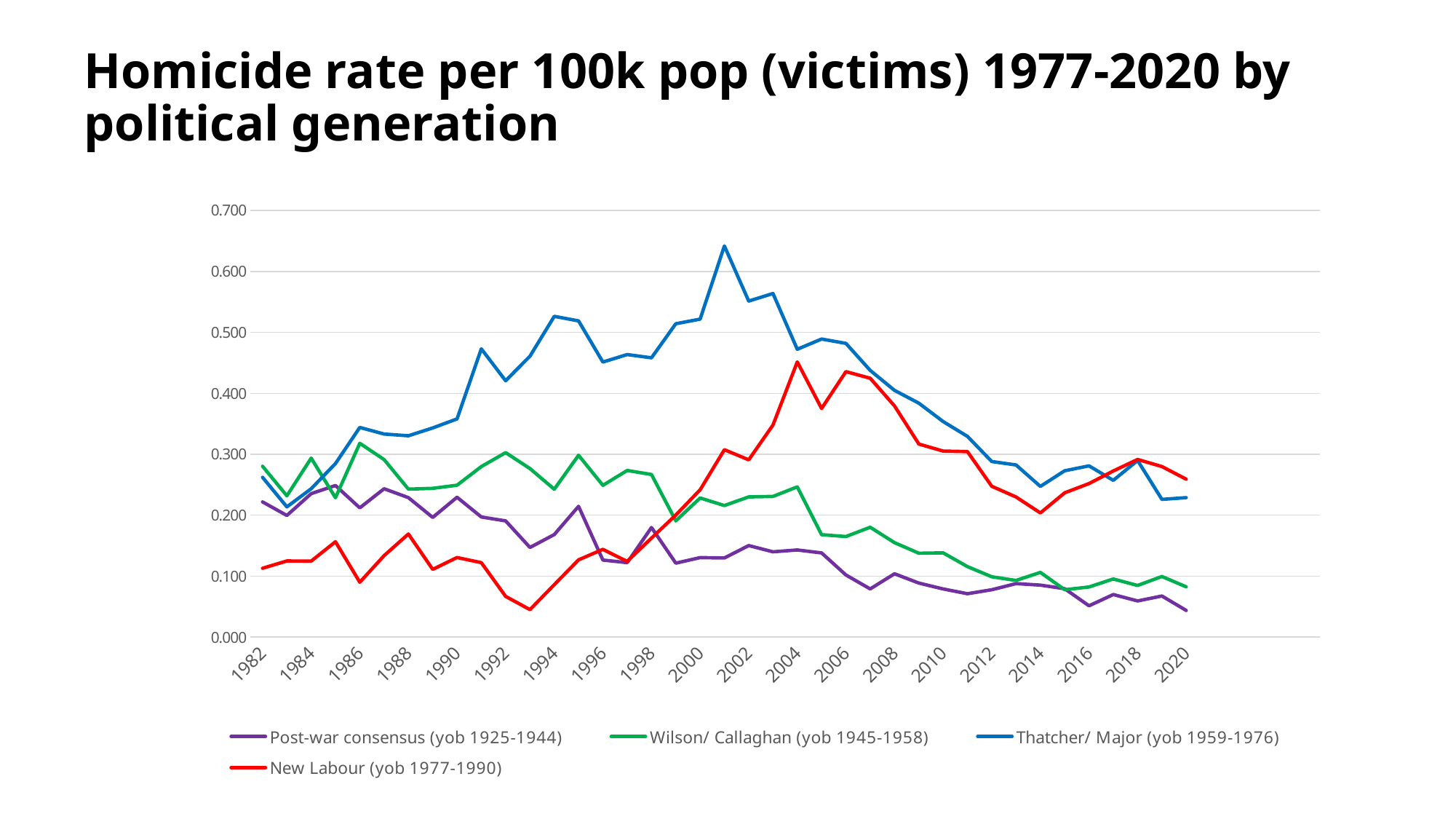
Does the Thatcher/ Major (yob 1959-1976) series generally rise or fall between 1982 and 2001? Rise Which series has the lowest value in 2020? Post-war consensus (yob 1925-1944) What is the title of the chart? Homicide rate per 100k pop (victims) 1977-2020 by political generation Is the value for Thatcher/ Major (yob 1959-1976) in 2001 greater or less than 0.600? greater Is the value for New Labour (yob 1977-1990) in 1993 greater or less than 0.100? less Is the value for Post-war consensus (yob 1925-1944) in 2020 greater or less than 0.100? less Which colour is used for the New Labour (yob 1977-1990) series? Red In 2001, which series has the higher value, Thatcher/ Major (yob 1959-1976) or New Labour (yob 1977-1990)? Thatcher/ Major (yob 1959-1976) How many series does the legend list? 4 Which series reaches the highest value anywhere on the chart? Thatcher/ Major (yob 1959-1976) What kind of chart is shown on the slide? Line chart